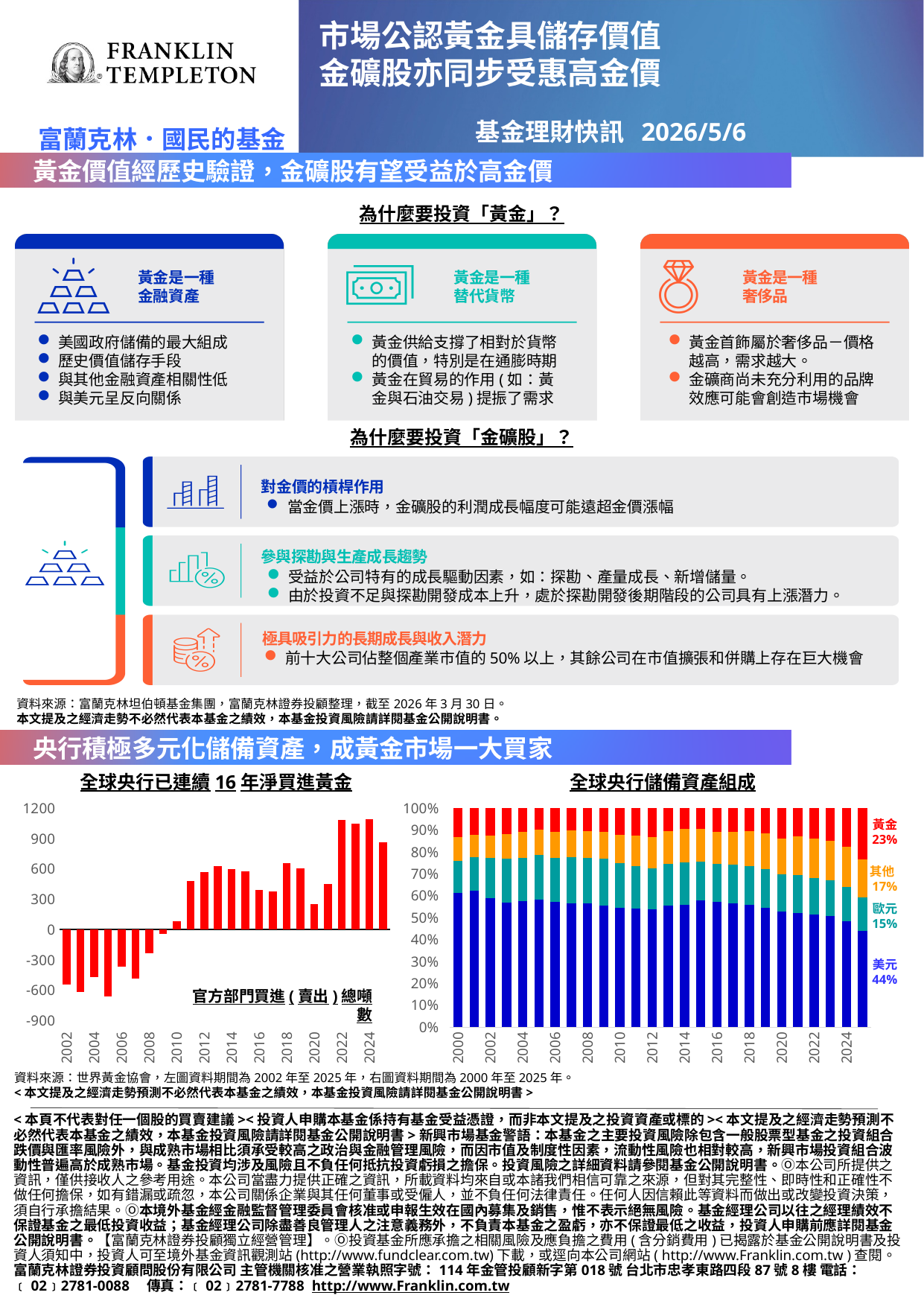
In the chart titled 全球央行已連續16年淨買進黃金, is the value for 2004 greater or less than -300? less In the chart titled 全球央行儲備資產組成, how many series does the legend list? 4 In the chart titled 全球央行儲備資產組成, which of the four labelled components has the smallest share? 歐元 In the chart titled 全球央行儲備資產組成, what share is labelled for 黃金 (gold)? 23% What kind of chart is the one titled 全球央行已連續16年淨買進黃金? bar chart In the chart titled 全球央行儲備資產組成, which of the four labelled components has the largest share? 美元 In the chart titled 全球央行儲備資產組成, what share is labelled for 美元? 44% In the chart titled 全球央行已連續16年淨買進黃金, which is larger, the value for 2012 or the value for 2002? 2012 In the chart titled 全球央行儲備資產組成, what is the difference between the labelled shares of 美元 and 黃金? 21 percentage points In the chart titled 全球央行儲備資產組成, what share is labelled for 歐元? 15% In the chart titled 全球央行已連續16年淨買進黃金, is the value for 2022 greater or less than 900? greater In the chart titled 全球央行儲備資產組成, does the share of 黃金 (red) rise or fall from 2000 to 2025? rise